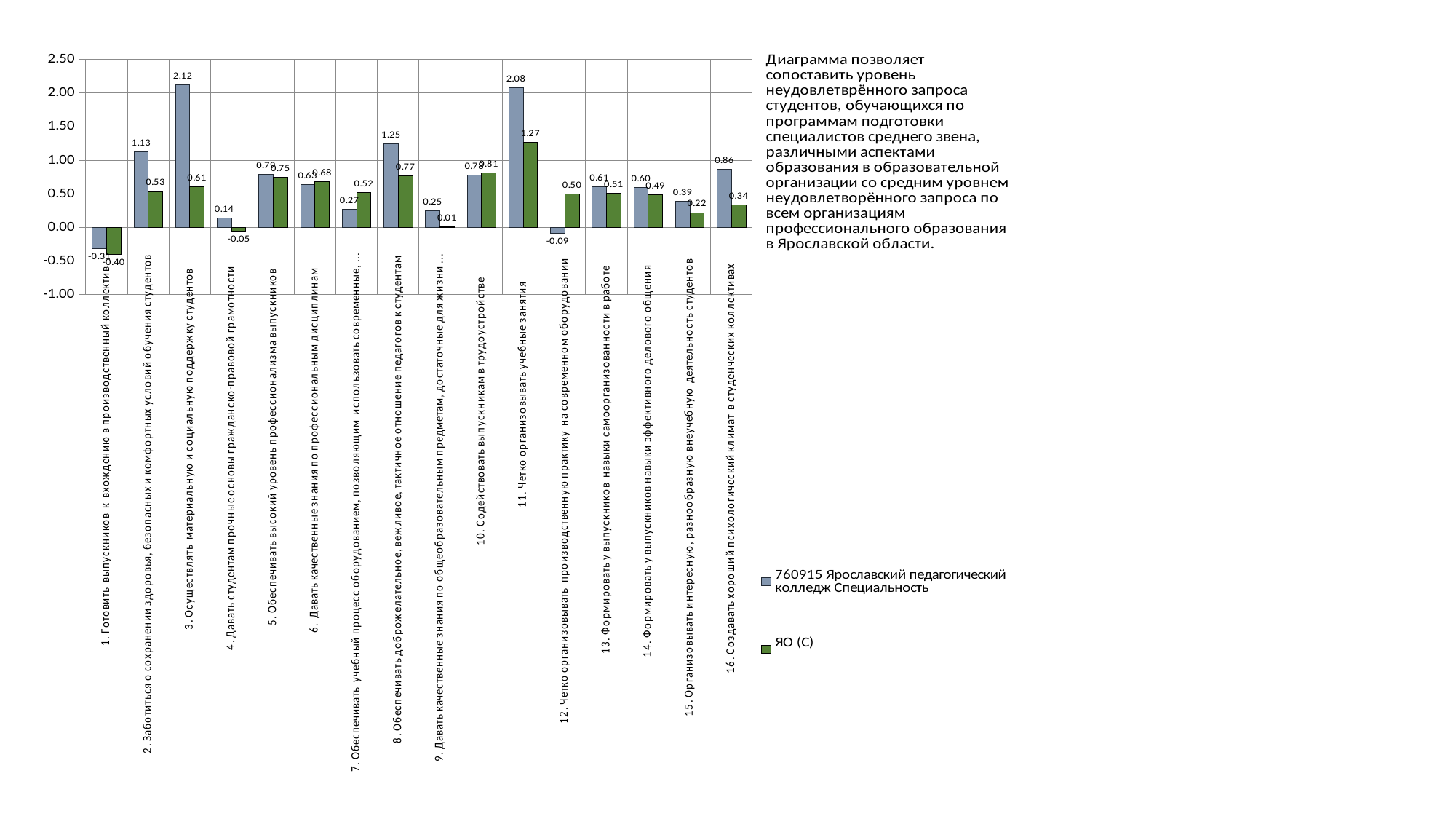
What kind of chart is shown on the slide? Bar chart How many categories are plotted along the x axis? 16 What is the value for 'ЯО (С)' in category '12. Четко организовывать производственную практику на современном оборудовании'? 0.50 Which category has the highest value for '760915 Ярославский педагогический колледж Специальность'? 3. Осуществлять материальную и социальную поддержку студентов What is the value for '760915 Ярославский педагогический колледж Специальность' in category '3. Осуществлять материальную и социальную поддержку студентов'? 2.12 Is the value for '760915 Ярославский педагогический колледж Специальность' in category '5. Обеспечивать высокий уровень профессионализма выпускников' greater or less than 0.50? greater What is the difference between the two series in category '8. Обеспечивать доброжелательное, вежливое, тактичное отношение педагогов к студентам'? 0.48 What is the difference between the two series in category '11. Четко организовывать учебные занятия'? 0.81 What is the value for 'ЯО (С)' in category '11. Четко организовывать учебные занятия'? 1.27 Which category has the lowest value for 'ЯО (С)'? 1. Готовить выпускников к вхождению в производственный коллектив How many series does the legend list? 2 In category '7. Обеспечивать учебный процесс оборудованием...', which series has the larger value? ЯО (С)